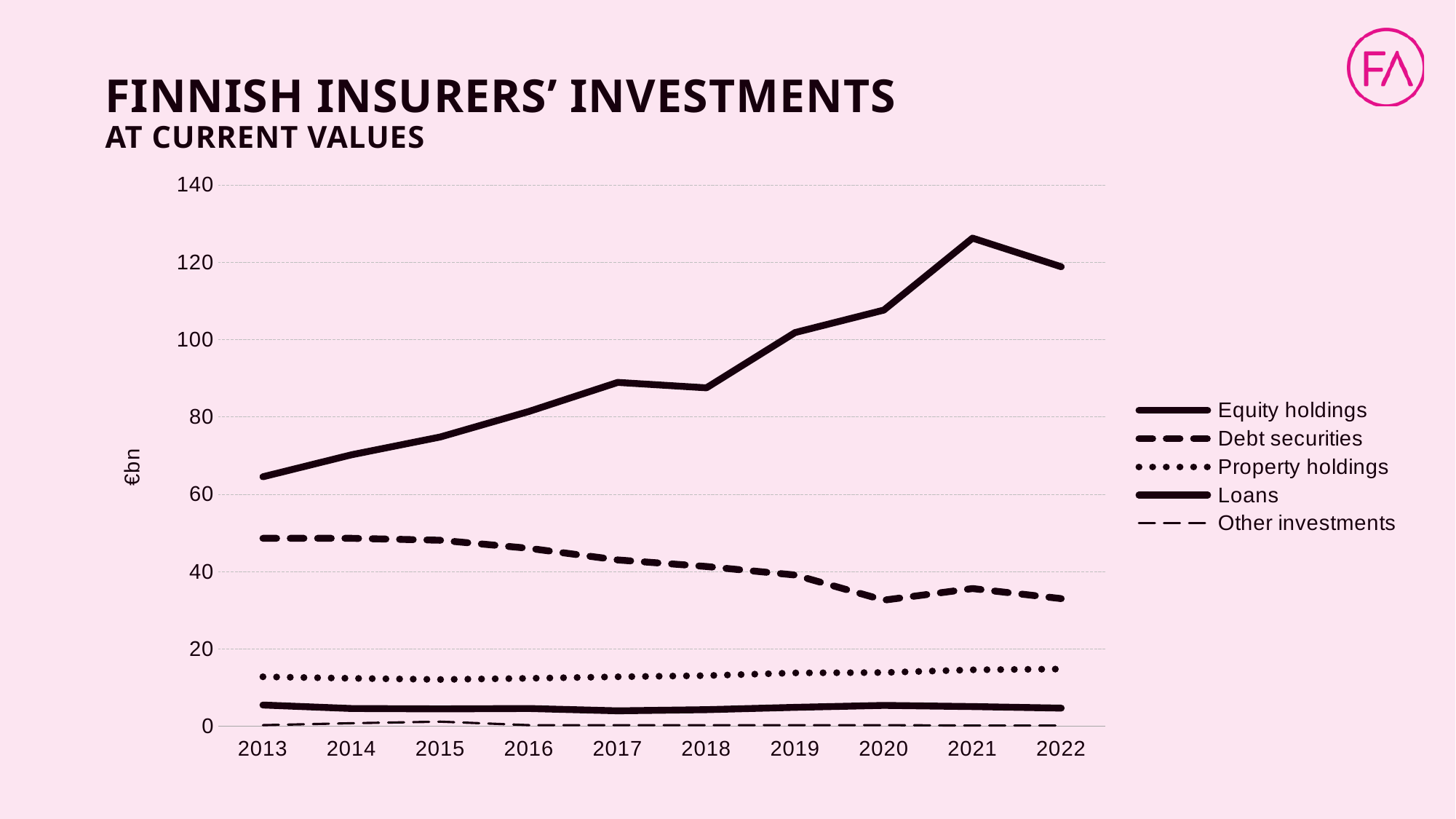
Is the value for Debt securities in 2020 greater or less than 40? less Is the value for Equity holdings in 2021 greater or less than 120? greater Do the values for Debt securities rise or fall overall from 2013 to 2022? fall Which series has the highest values across the whole period? Equity holdings Do the values for Equity holdings rise or fall overall from 2013 to 2022? rise In which year is the value for Equity holdings highest? 2021 How many series does the legend list? 5 How many years are shown on the x axis? 10 Which series has the lowest values across the whole period? Other investments What unit is shown on the y axis label? €bn What kind of chart is shown on the slide? line chart In which year is the value for Equity holdings lowest? 2013